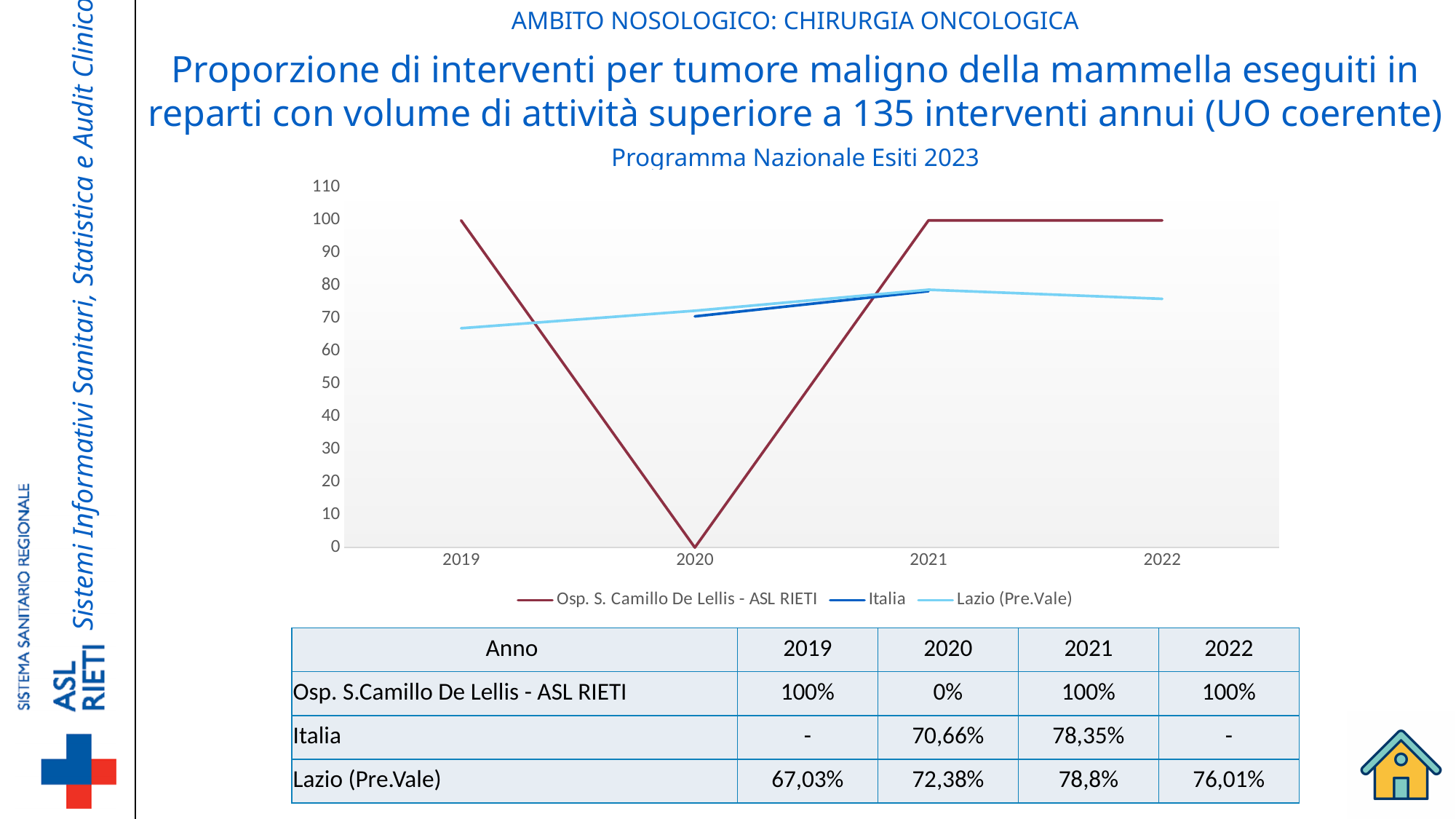
How many series does the chart legend list? 3 What kind of chart is shown on the slide? line chart What is the value for Osp. S.Camillo De Lellis - ASL RIETI in 2020? 0% What is the value for Italia in 2021? 78,35% Does the Italia line rise or fall from 2020 to 2021? rise What is the value for Lazio (Pre.Vale) in 2019? 67,03% Which is larger in 2020: the value for Italia or the value for Lazio (Pre.Vale)? Lazio (Pre.Vale) In which year is the value for Osp. S.Camillo De Lellis - ASL RIETI lowest? 2020 Is the value for Lazio (Pre.Vale) in 2019 greater or less than 60? greater In which year is the value for Lazio (Pre.Vale) highest? 2021 What is the value for Lazio (Pre.Vale) in 2022? 76,01% How many years are plotted along the x axis of the chart? 4